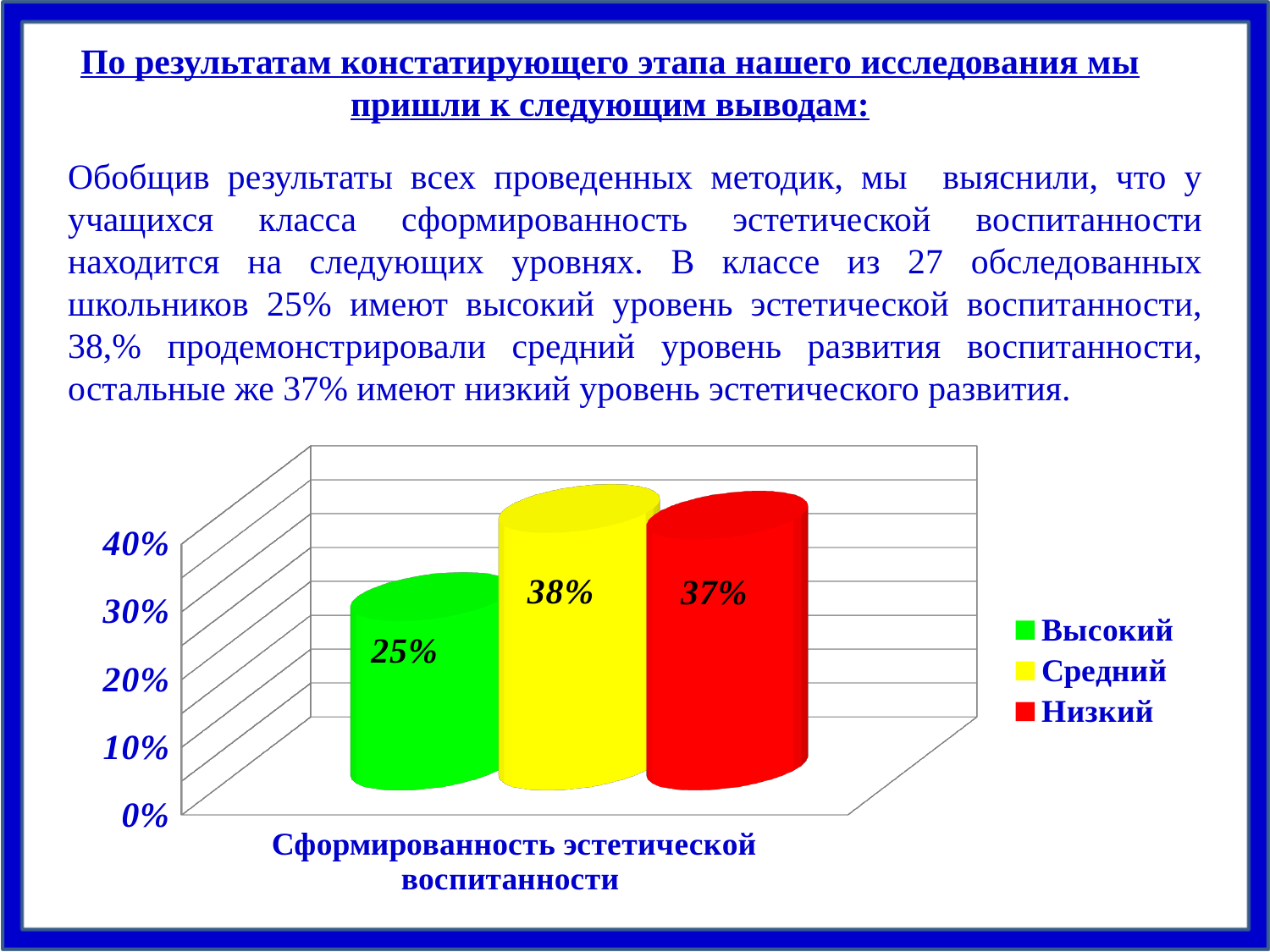
Which is larger, the value for Средний or the value for Низкий? Средний What is the difference between the values for Низкий and Высокий? 12% How many series does the legend list? 3 What is the value for Средний in the chart? 38% Which series has the lowest value in the chart? Высокий What is the value for Высокий in the chart? 25% Which series has the highest value in the chart? Средний What is the difference between the values for Средний and Высокий? 13% Is the value for Высокий greater or less than 30%? less What colour is the bar for Низкий? red What is the value for Низкий in the chart? 37% What kind of chart is shown on the slide? bar chart